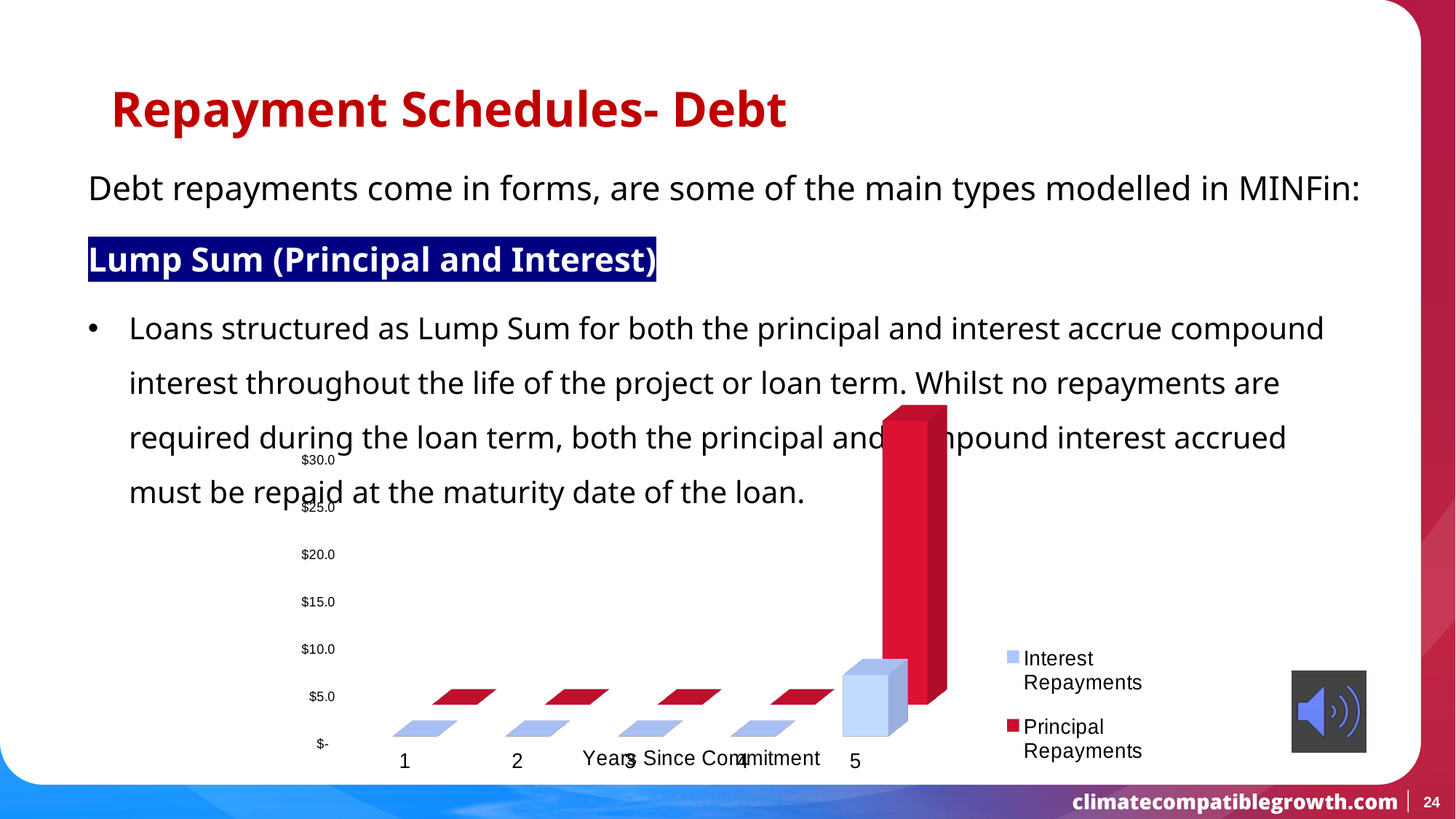
What kind of chart is shown on the slide? bar chart Is the value for Principal Repayments in year 5 greater or less than $25.0? greater What are the two series named in the chart legend? Interest Repayments and Principal Repayments In which year are the Principal Repayments highest? 5 Is the value for Interest Repayments in year 5 greater or less than $10.0? less Is the value for Interest Repayments in year 5 greater or less than $5.0? greater In which year are the Interest Repayments highest? 5 Do the Principal Repayments rise or fall from year 4 to year 5? rise How many series does the chart legend list? 2 What is the title of the x axis of the chart? Years Since Commitment How many years are shown along the x axis of the chart? 5 In year 5, which is larger: Principal Repayments or Interest Repayments? Principal Repayments